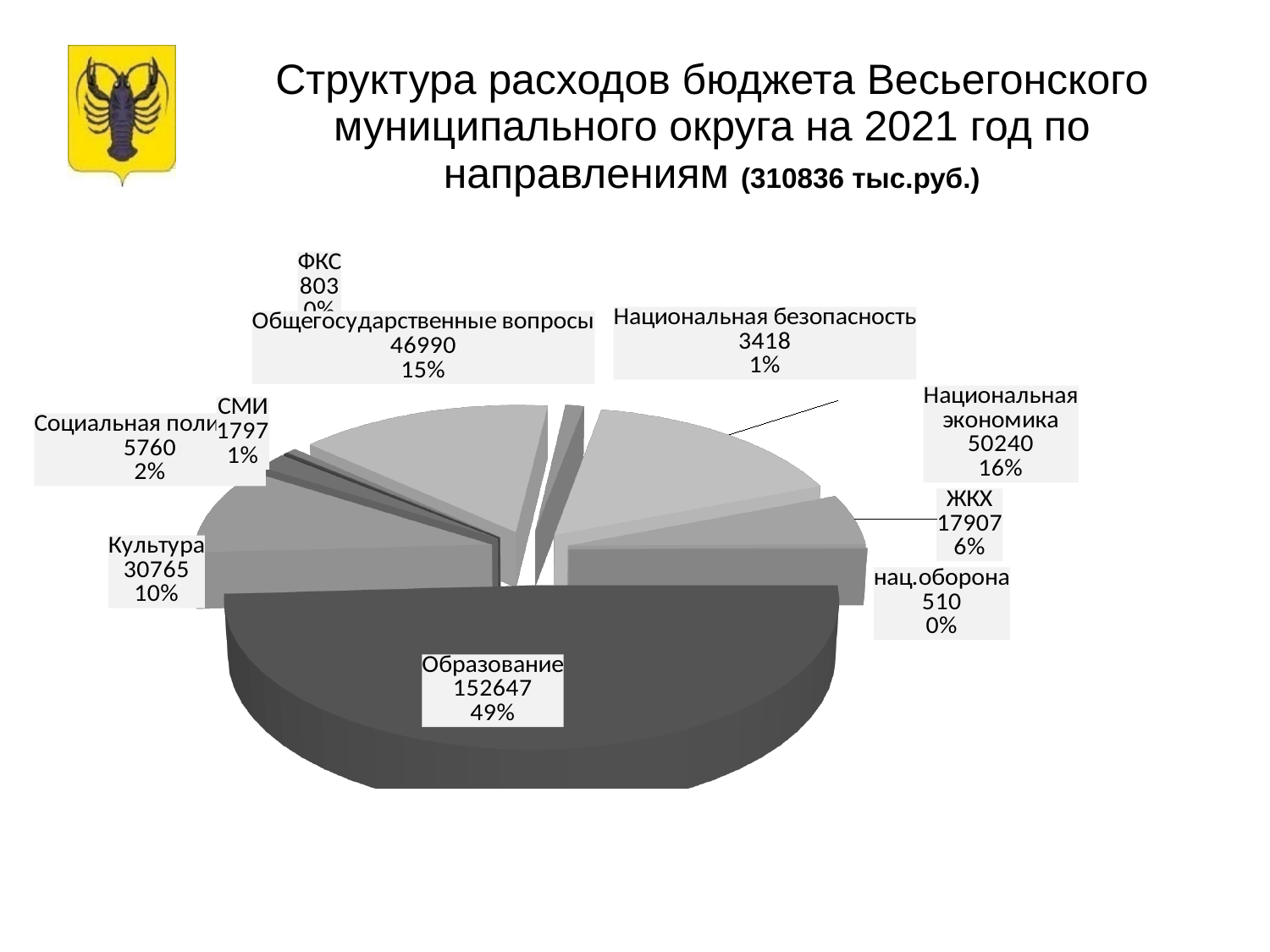
What is the difference between the values for Национальная экономика and Общегосударственные вопросы? 3250 What is the value for Образование? 152647 What share of the pie does Образование take? 49% How many categories are shown in the pie chart? 10 What is the value for ЖКХ? 17907 What total amount in тыс.руб. is given in the chart title? 310836 тыс.руб. What kind of chart is shown on the slide? pie chart Which category has the smallest value? нац.оборона What share of the pie does Общегосударственные вопросы take? 15% Which category has the largest slice of the pie? Образование Which is larger, the value for Культура or the value for ЖКХ? Культура What is the value for Национальная экономика? 50240